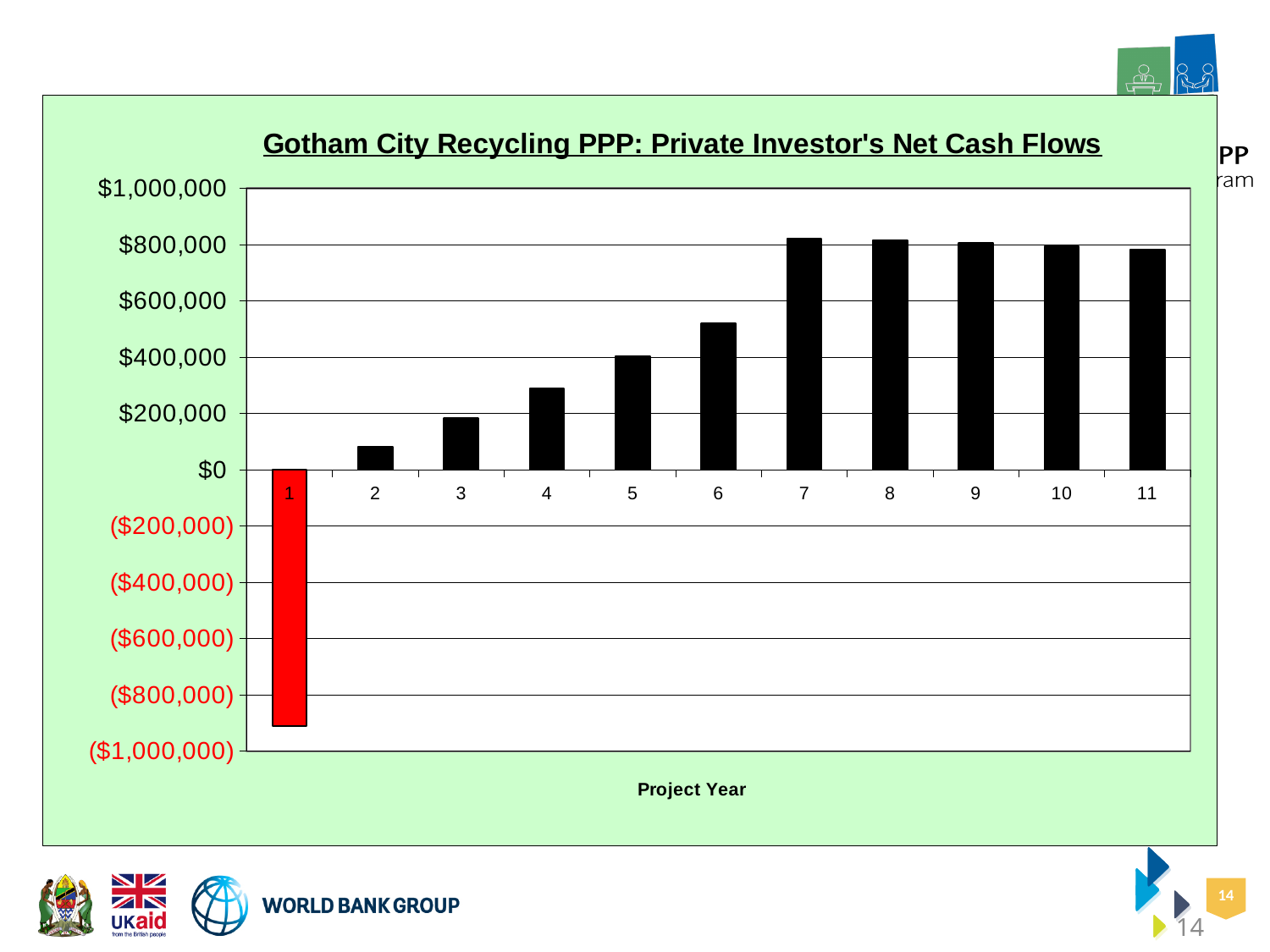
Is the net cash flow for project year 6 greater or less than $400,000? greater How many project years are plotted on the chart? 11 Which has the larger net cash flow, project year 4 or project year 6? project year 6 What is the label on the x axis of the chart? Project Year Which has the larger net cash flow, project year 2 or project year 3? project year 3 Do the net cash flows rise or fall from project year 2 to project year 7? rise Is the net cash flow for project year 1 greater or less than ($800,000)? less Which project year has the lowest net cash flow? 1 Is the net cash flow for project year 4 greater or less than $200,000? greater What kind of chart is shown on the slide? bar chart What is the title of the chart? Gotham City Recycling PPP: Private Investor's Net Cash Flows